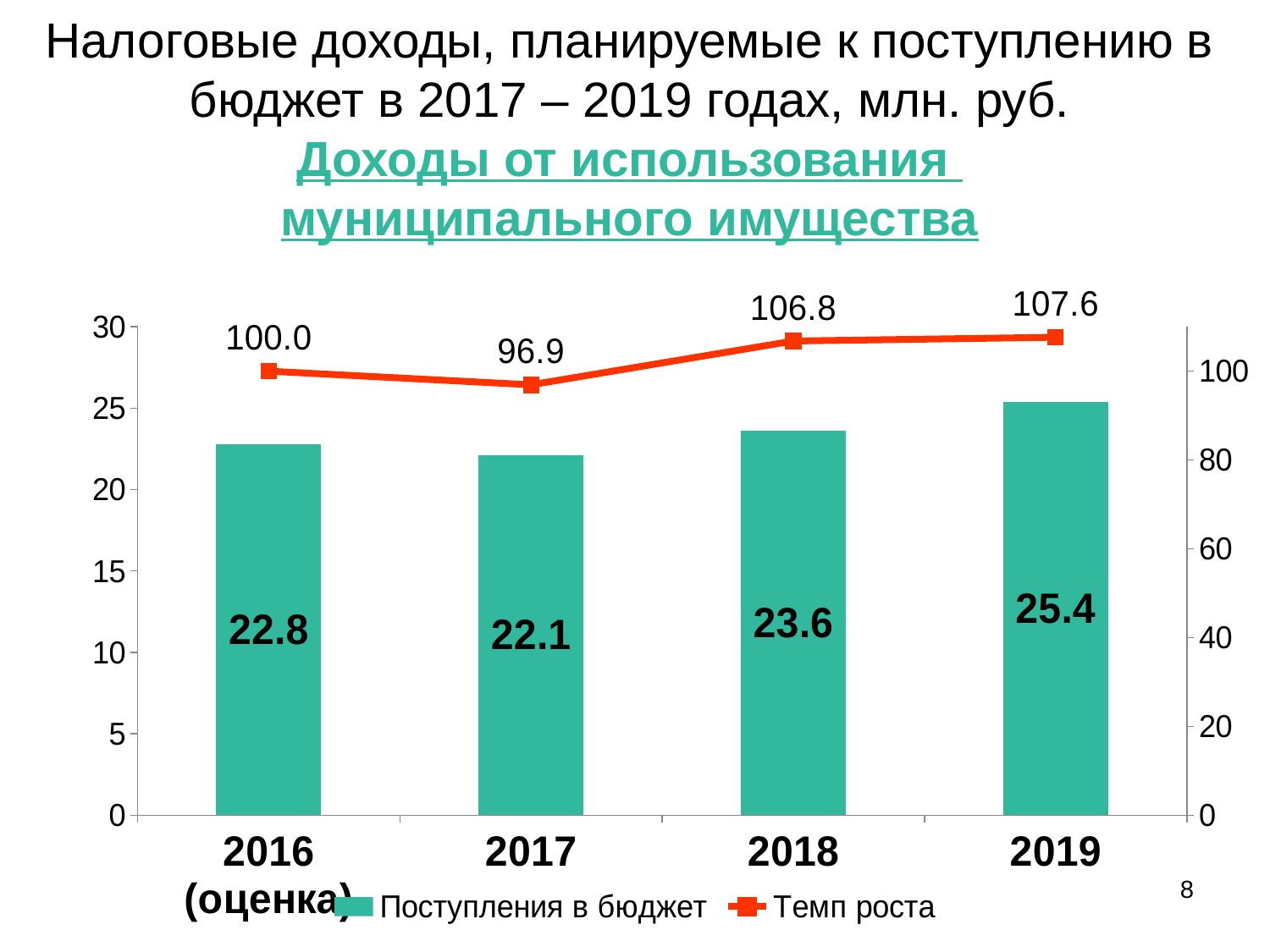
Which year has the highest value of "Поступления в бюджет"? 2019 What is the value of "Поступления в бюджет" for 2019? 25.4 What is the value of "Темп роста" for 2016 (оценка)? 100.0 Does "Поступления в бюджет" rise or fall from 2017 to 2019? rise What is the value of "Поступления в бюджет" for 2017? 22.1 Which year has the lowest value of "Темп роста"? 2017 Which is larger: "Поступления в бюджет" in 2016 (оценка) or in 2018? 2018 What is the difference between "Поступления в бюджет" in 2019 and in 2016 (оценка)? 2.6 What is the value of "Темп роста" for 2018? 106.8 How many series does the legend list? 2 How many years are shown on the x axis? 4 What kind of chart is used for the "Поступления в бюджет" series? bar chart